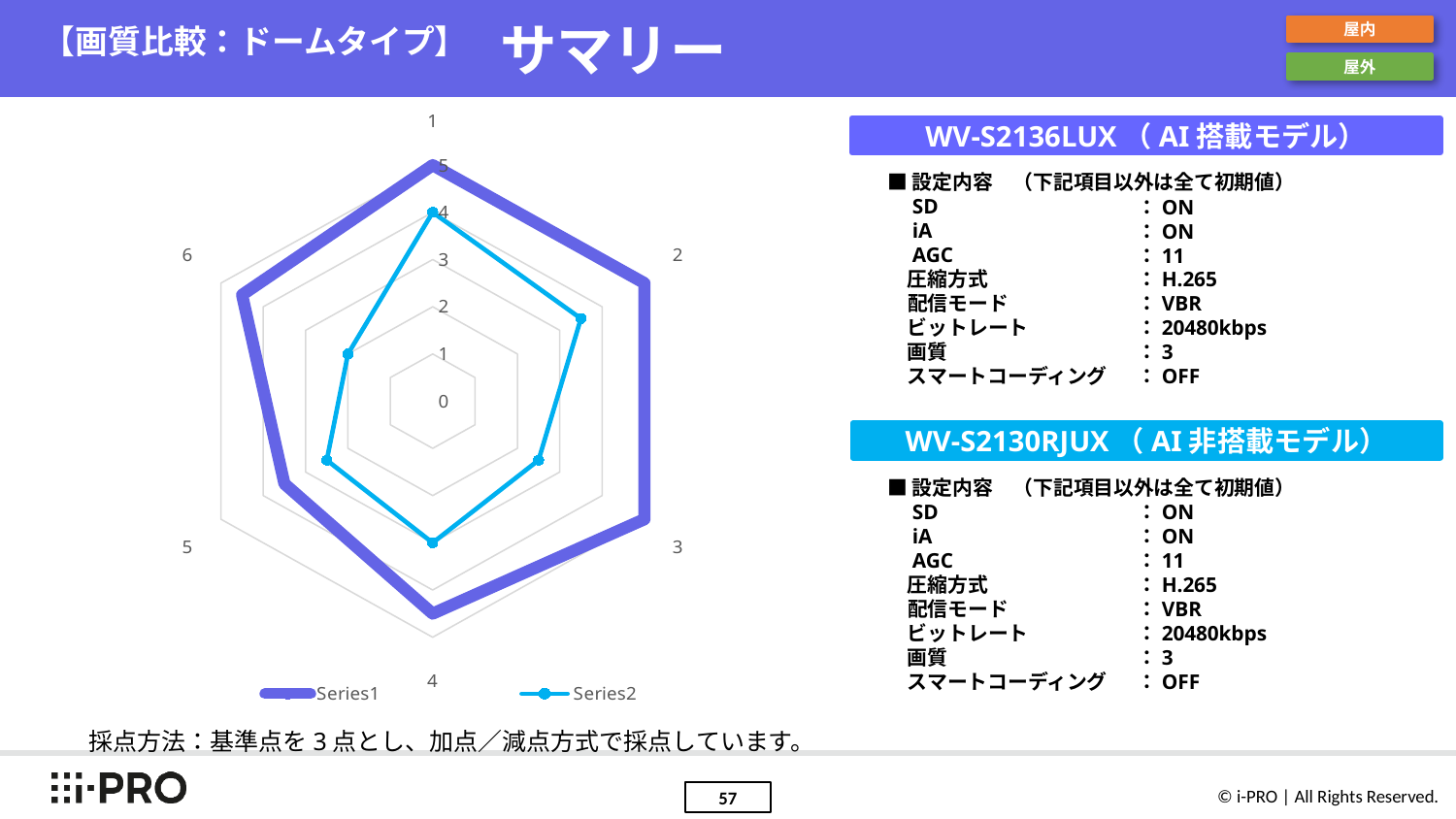
In the radar chart, which series has the larger value for category 1, Series1 or Series2? Series1 In the radar chart, is the value of Series2 for category 5 greater or less than 3? less What is the highest tick value shown on the radar chart's axis? 5 How many categories (axes) does the radar chart have? 6 What kind of chart is shown on the left of the slide? radar chart What is the value of Series2 for category 1 in the radar chart? 4 In the radar chart, for which category does Series2 have its highest value? 1 What is the value of Series1 for category 1 in the radar chart? 5 How many series does the legend of the radar chart list? 2 What are the names of the two series in the radar chart legend? Series1 and Series2 In the radar chart, is the value of Series2 for category 6 greater or less than 3? less In the radar chart, is the value of Series2 for category 2 greater or less than 3? greater